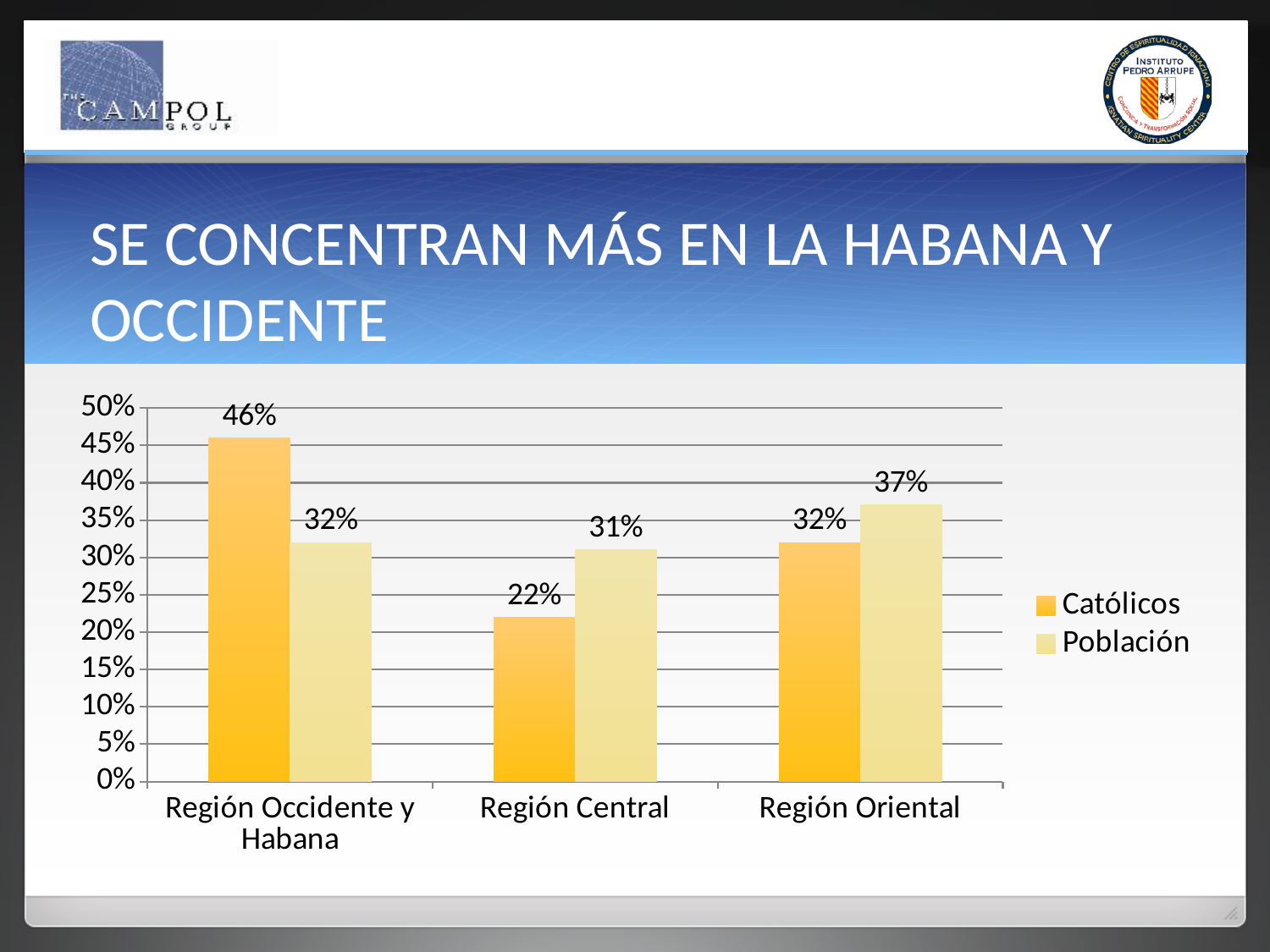
How many regions are shown on the x axis? 3 Which region has the highest Católicos value? Región Occidente y Habana How many series does the legend list? 2 What is the difference between the Católicos and Población values for Región Occidente y Habana? 14% For Región Oriental, which is larger: Católicos or Población? Población What is the Población value for Región Oriental? 37% What is the Población value for Región Central? 31% Which region has the lowest Católicos value? Región Central What are the two series named in the legend? Católicos and Población What kind of chart is shown on the slide? Bar chart What is the Católicos value for Región Occidente y Habana? 46% What is the difference between the Población and Católicos values for Región Central? 9%